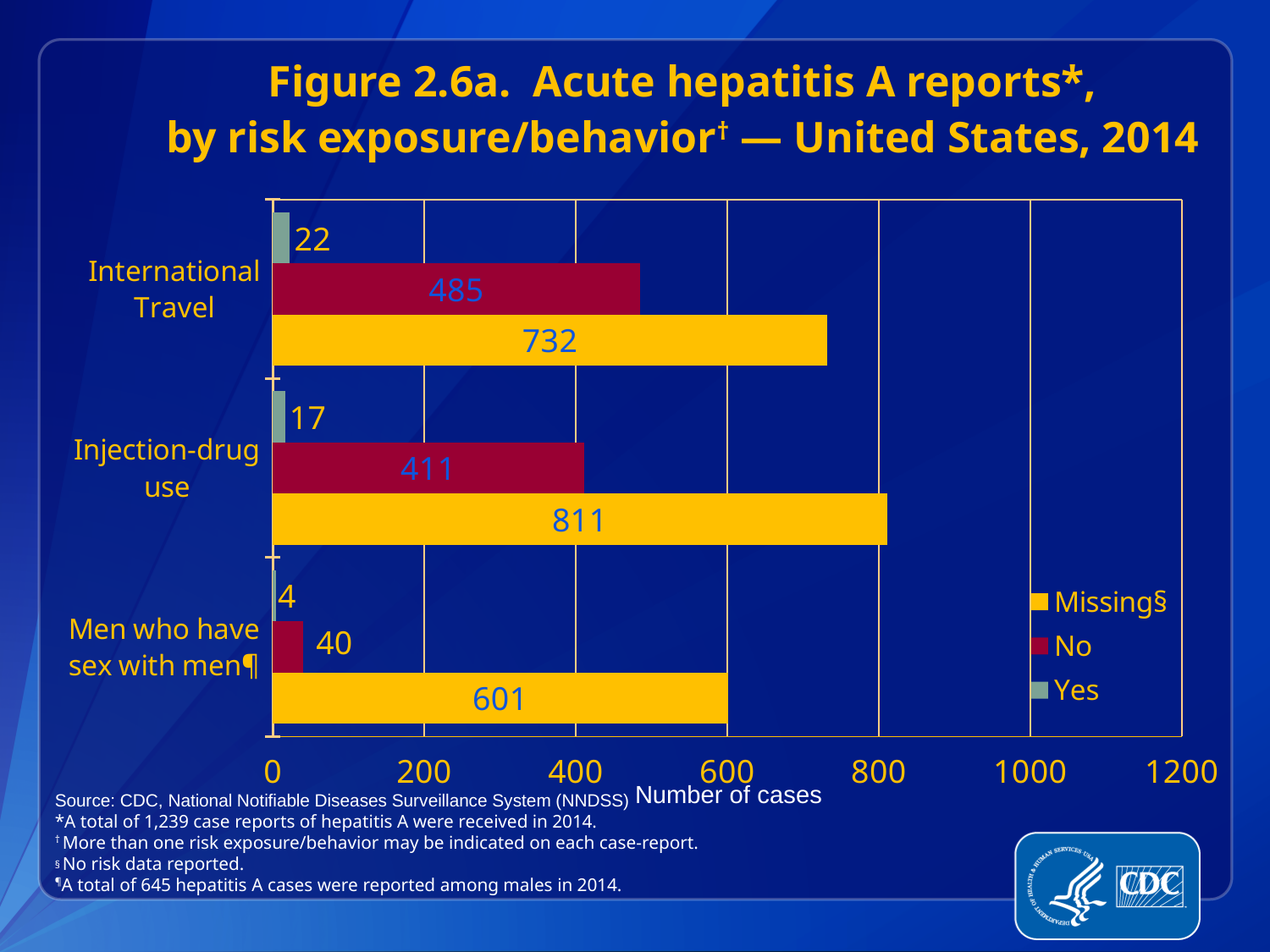
What is the difference between the 'No' values for International Travel and Injection-drug use? 74 What is the number of cases for 'Missing' in the Injection-drug use category? 811 Which is larger: the 'Missing' value for International Travel or the 'Missing' value for Men who have sex with men? International Travel What is the number of cases for 'Yes' in the International Travel category? 22 Is the 'No' value for Injection-drug use greater or less than 400? greater Which category has the highest 'Missing' value? Injection-drug use What is the label of the x axis? Number of cases What kind of chart is shown on the slide? bar chart Which category has the lowest 'Yes' value? Men who have sex with men What is the number of cases for 'No' in the Men who have sex with men category? 40 How many risk exposure/behavior categories are shown on the chart? 3 How many series does the legend list? 3